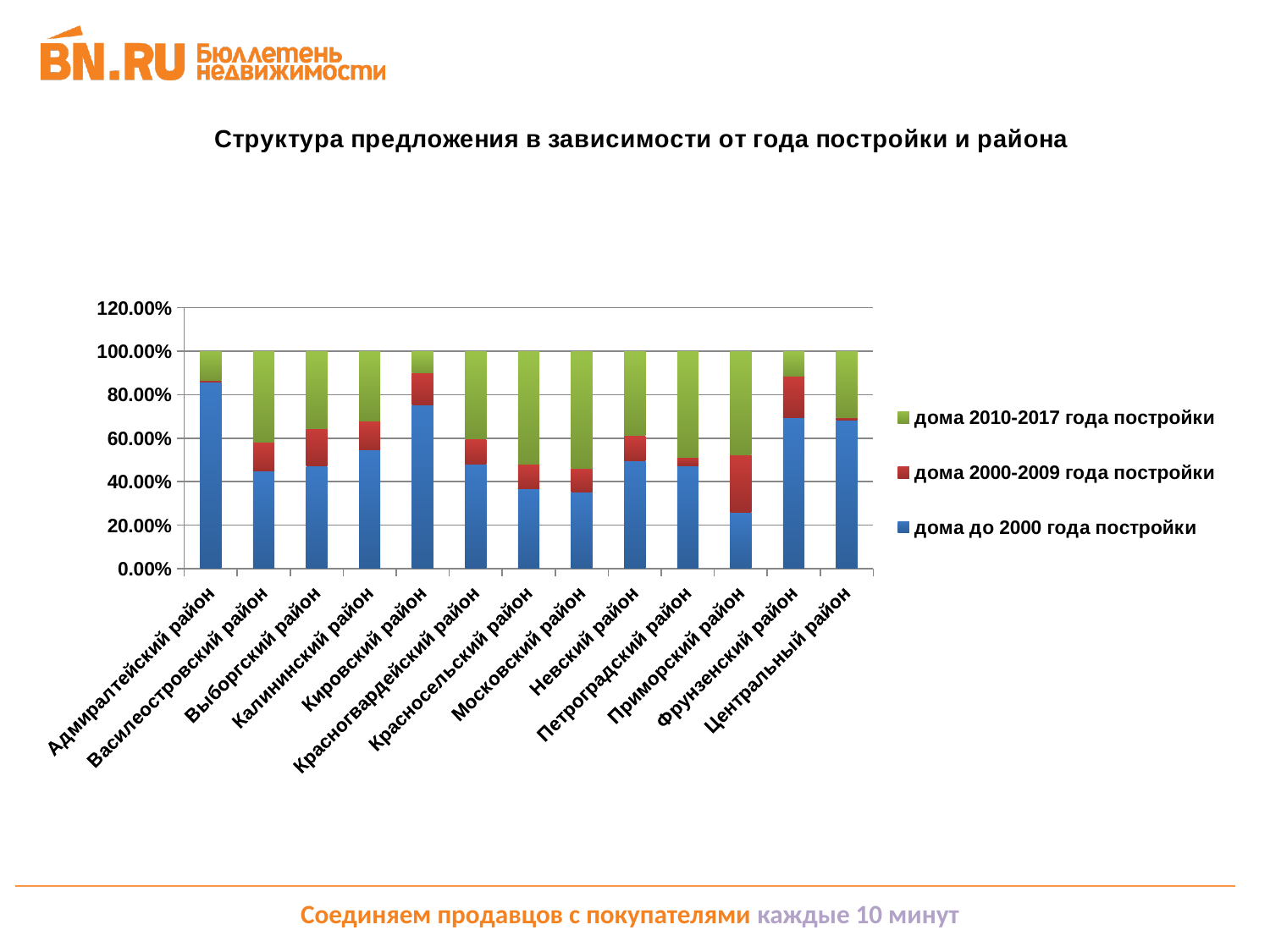
How many series does the chart legend list? 3 Which district has the highest share of 'дома до 2000 года постройки'? Адмиралтейский район What is the total height of the stacked bar for Невский район? 100.00% Which district has the highest share of 'дома 2000-2009 года постройки'? Приморский район Which series is shown in green in the chart? дома 2010-2017 года постройки What kind of chart is shown on the slide? stacked bar chart How many districts (categories) are shown on the x axis of the chart? 13 Is the share of 'дома до 2000 года постройки' for Адмиралтейский район greater or less than 80.00%? greater Which district has the lowest share of 'дома до 2000 года постройки'? Приморский район Which district has a larger share of 'дома до 2000 года постройки': Кировский район or Московский район? Кировский район Is the share of 'дома до 2000 года постройки' for Приморский район greater or less than 40.00%? less What is the title of the chart? Структура предложения в зависимости от года постройки и района